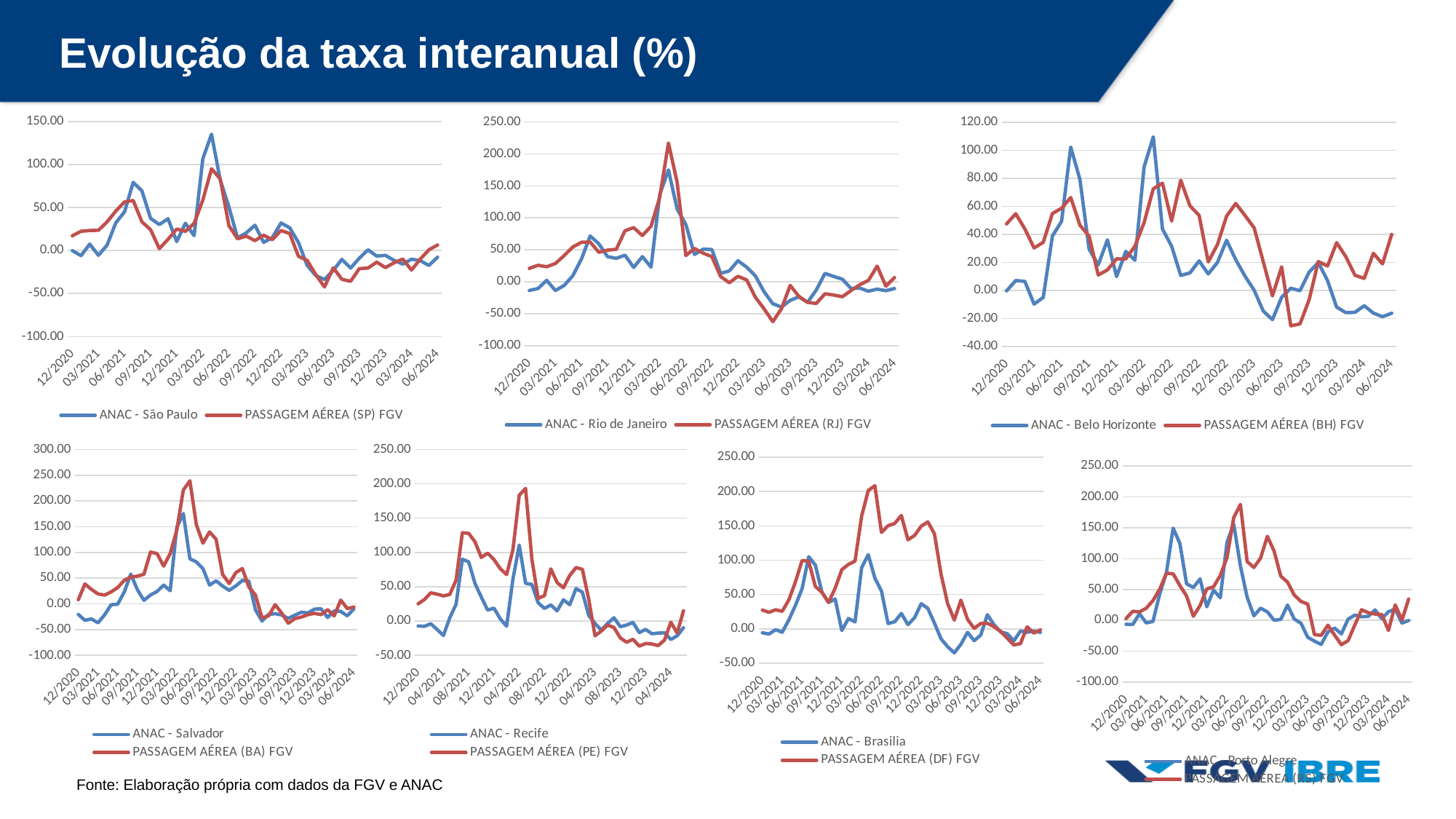
In the third chart of the bottom row (ANAC - Brasilia), is the peak value of the PASSAGEM AÉREA (DF) FGV series greater or less than 150? greater What is the title of the slide containing these charts? Evolução da taxa interanual (%) In the top-left chart (ANAC - São Paulo), which series reaches the higher peak: ANAC - São Paulo or PASSAGEM AÉREA (SP) FGV? ANAC - São Paulo In the top-right chart, what colour is the line for the PASSAGEM AÉREA (BH) FGV series? red In the top-middle chart (ANAC - Rio de Janeiro), is the peak value of the PASSAGEM AÉREA (RJ) FGV series greater or less than 200? greater In the top-right chart (ANAC - Belo Horizonte), is the peak value of the ANAC - Belo Horizonte series greater or less than 100? greater How many series does the legend of the top-middle chart (ANAC - Rio de Janeiro) list? 2 What kind of chart is the top-left chart (ANAC - São Paulo)? line chart In the top-middle chart (ANAC - Rio de Janeiro), which series reaches the higher peak: ANAC - Rio de Janeiro or PASSAGEM AÉREA (RJ) FGV? PASSAGEM AÉREA (RJ) FGV